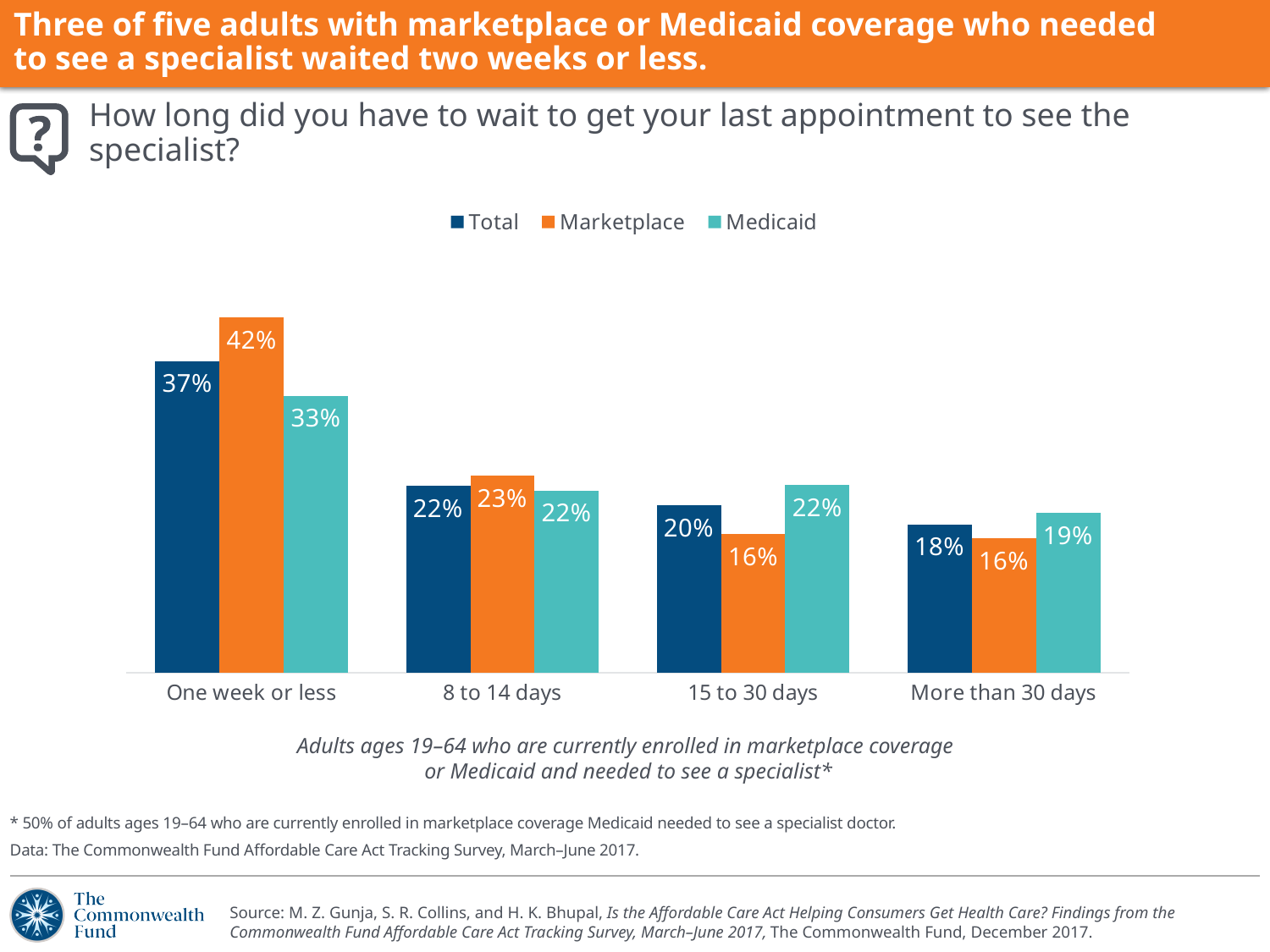
Which category has the highest Total value? One week or less What is the Total value for 'More than 30 days'? 18% How many wait-time categories are shown on the x axis? 4 Which category has the lowest Marketplace value? 15 to 30 days and More than 30 days (both 16%) What is the difference between the Marketplace and Medicaid values for 'One week or less'? 9 percentage points Which series is shown in orange in the legend? Marketplace How many series does the legend list? 3 For '15 to 30 days', which is larger: the Marketplace value or the Medicaid value? Medicaid What is the Marketplace value for 'One week or less'? 42% Do the Total values rise or fall moving from 'One week or less' to 'More than 30 days'? Fall What kind of chart is shown on the slide? Bar chart What is the Medicaid value for '15 to 30 days'? 22%